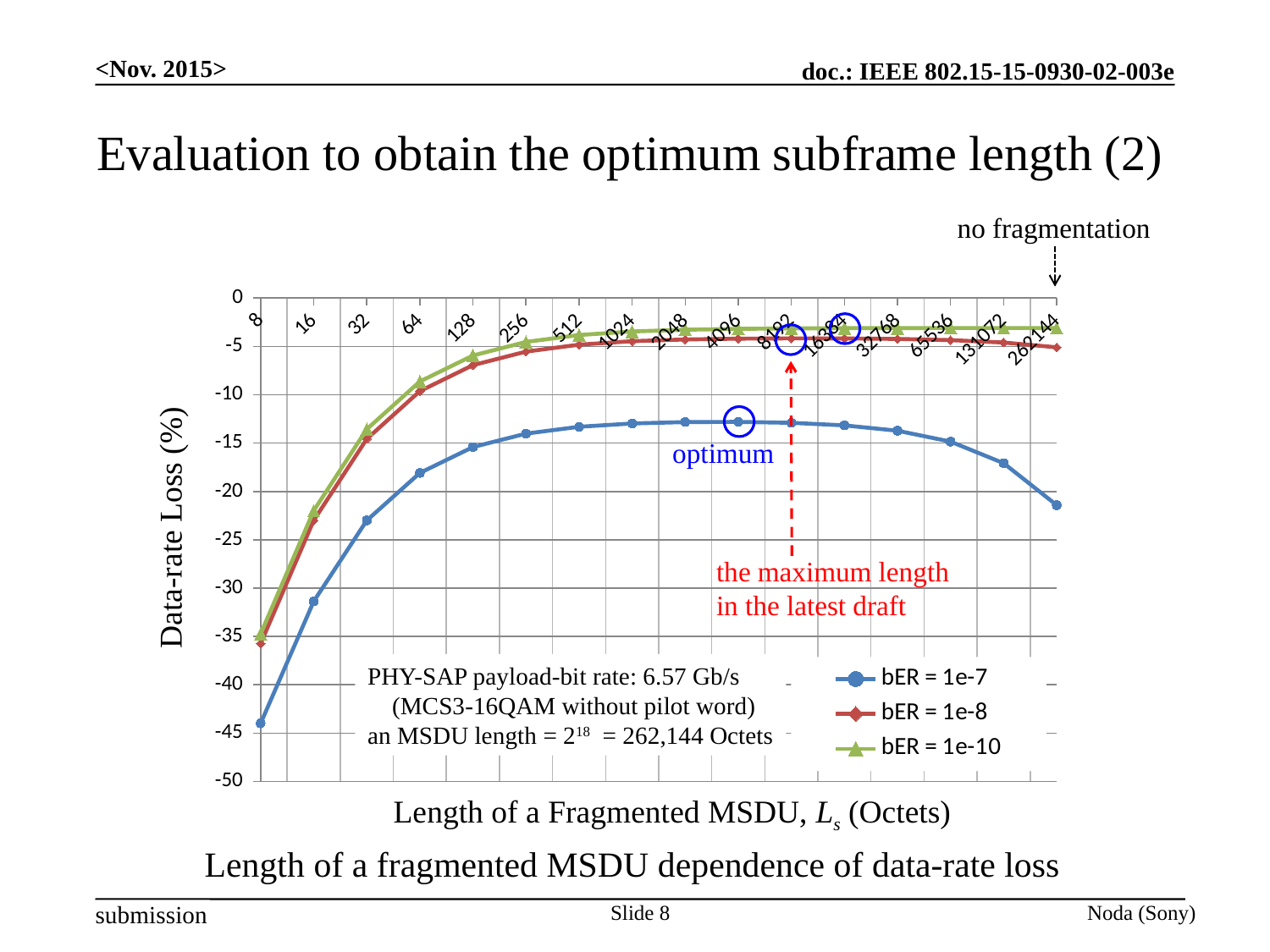
Is the value for the bER = 1e-10 series at 8 octets greater or less than -30? less Does the bER = 1e-7 series rise or fall as the length increases from 8 to 2048 octets? rise What is the title of the y axis? Data-rate Loss (%) Is the value for the bER = 1e-8 series at 4096 octets greater or less than -10? greater How many points are plotted along the x axis for each series? 16 For the bER = 1e-7 series, at which length of a fragmented MSDU is the data-rate loss lowest (most negative)? 8 At 8 octets, which series has the larger (less negative) data-rate loss, bER = 1e-7 or bER = 1e-10? bER = 1e-10 Is the value for the bER = 1e-7 series at 262144 octets greater or less than -25? greater What kind of chart is shown on the slide? line chart At 16 octets, which series has the larger (less negative) value, bER = 1e-7 or bER = 1e-8? bER = 1e-8 How many series does the legend list? 3